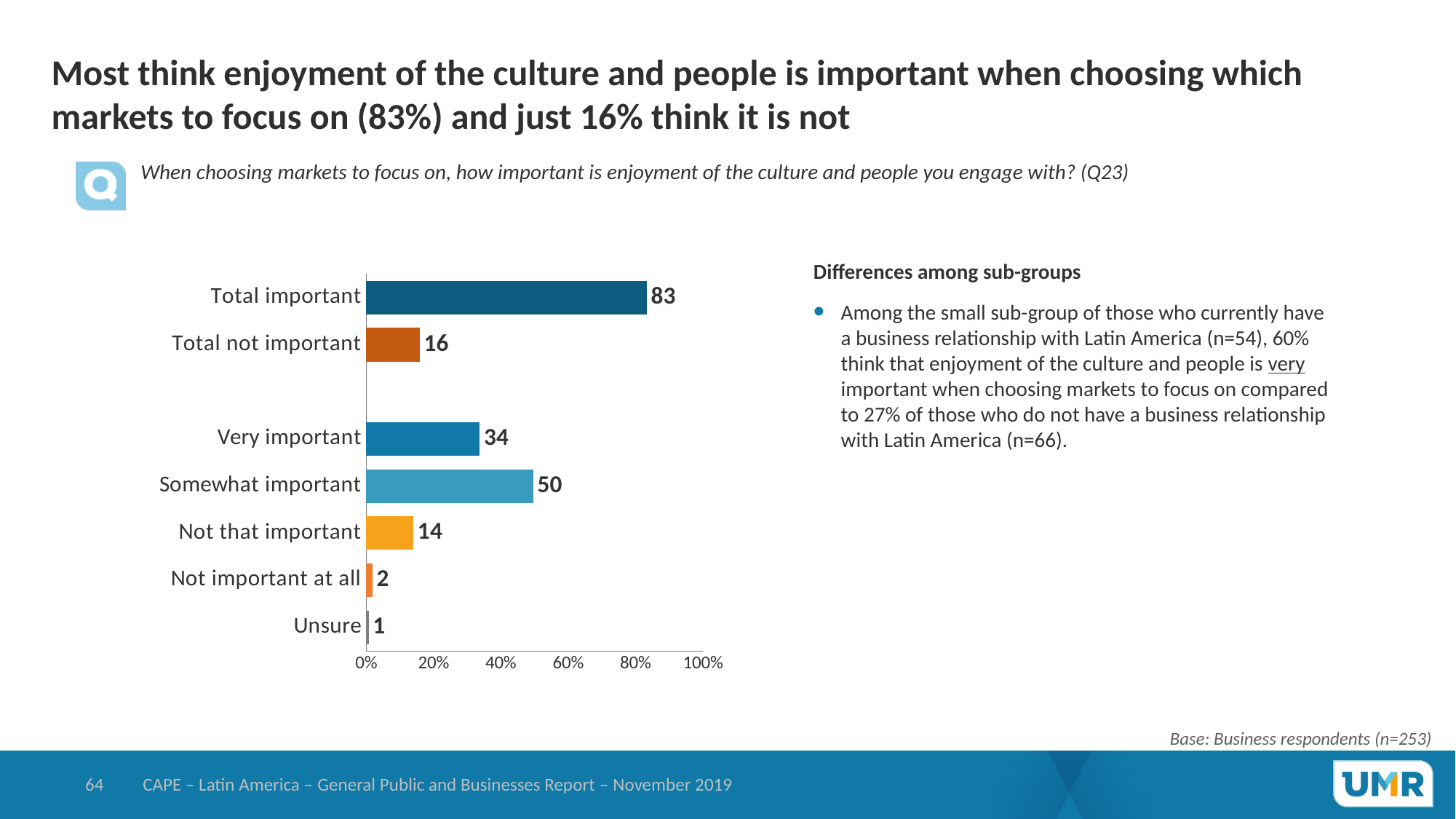
Which category has the highest value? Total important Which is larger, Not that important or Not important at all? Not that important What is the value for Not that important? 14 What is the difference between Total important and Total not important? 67 What is the value for Unsure? 1 How many categories are shown on the chart? 7 What is the highest value shown on the x axis? 100% What is the value for Total important? 83 What is the difference between Very important and Somewhat important? 16 Which category has the lowest value? Unsure What is the value for Somewhat important? 50 What kind of chart is shown? Bar chart